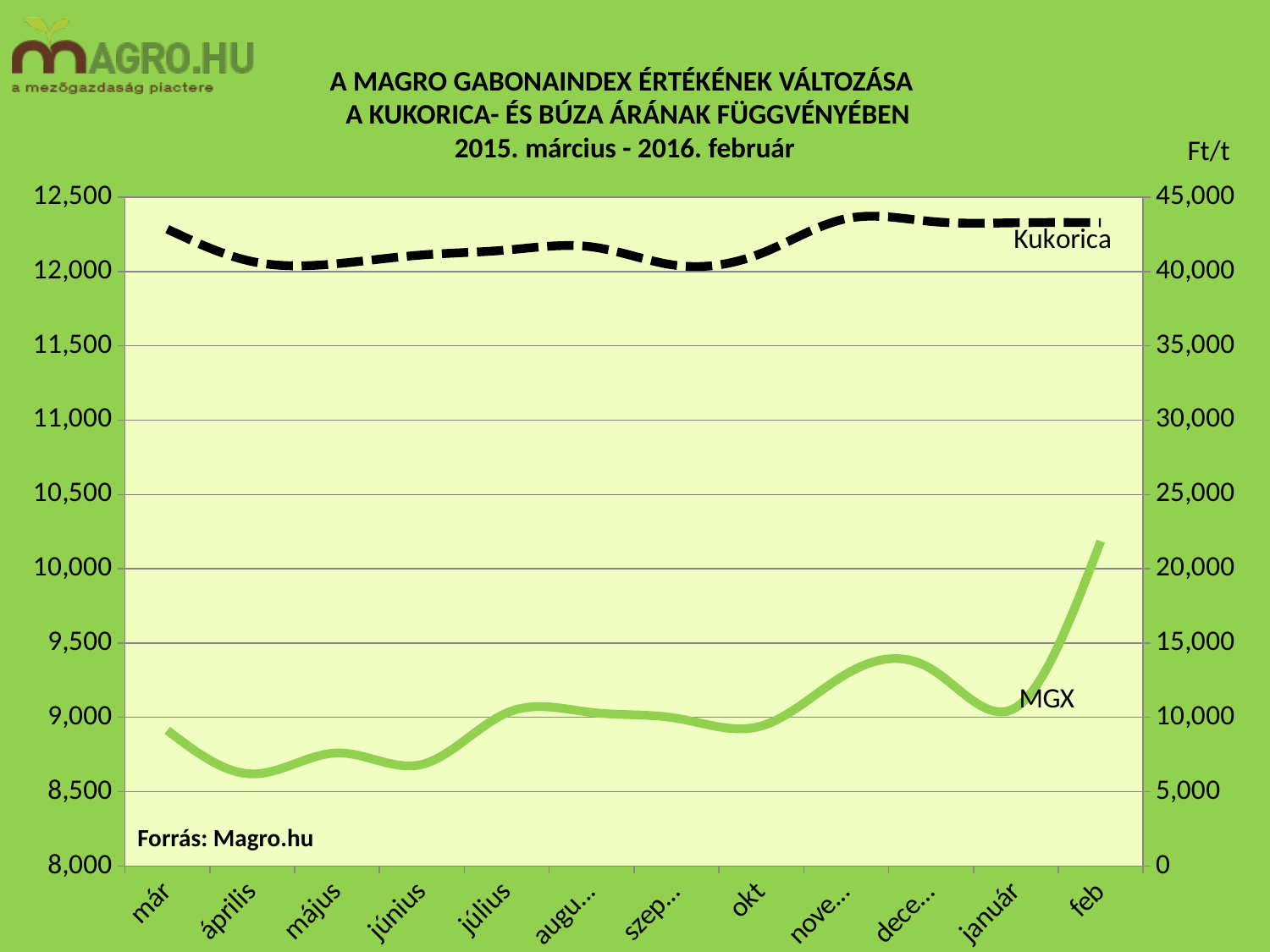
Which month has the highest MGX value? feb How many months (points) are shown along the x axis? 12 Read on the left axis, is the MGX value for április greater or less than 9,000? less Which is larger, the Kukorica value for nove... or the Kukorica value for május? nove... Does the Kukorica line rise or fall between már and május? fall Read on the left axis, is the MGX value for feb greater or less than 10,000? greater What kind of chart is shown on the slide? line chart Which series is drawn with a dashed black line? Kukorica Does the MGX line rise or fall between január and feb? rise Which is larger, the MGX value for feb or the MGX value for már? feb How many data series are plotted on the chart? 2 What source is cited at the bottom of the chart? Forrás: Magro.hu